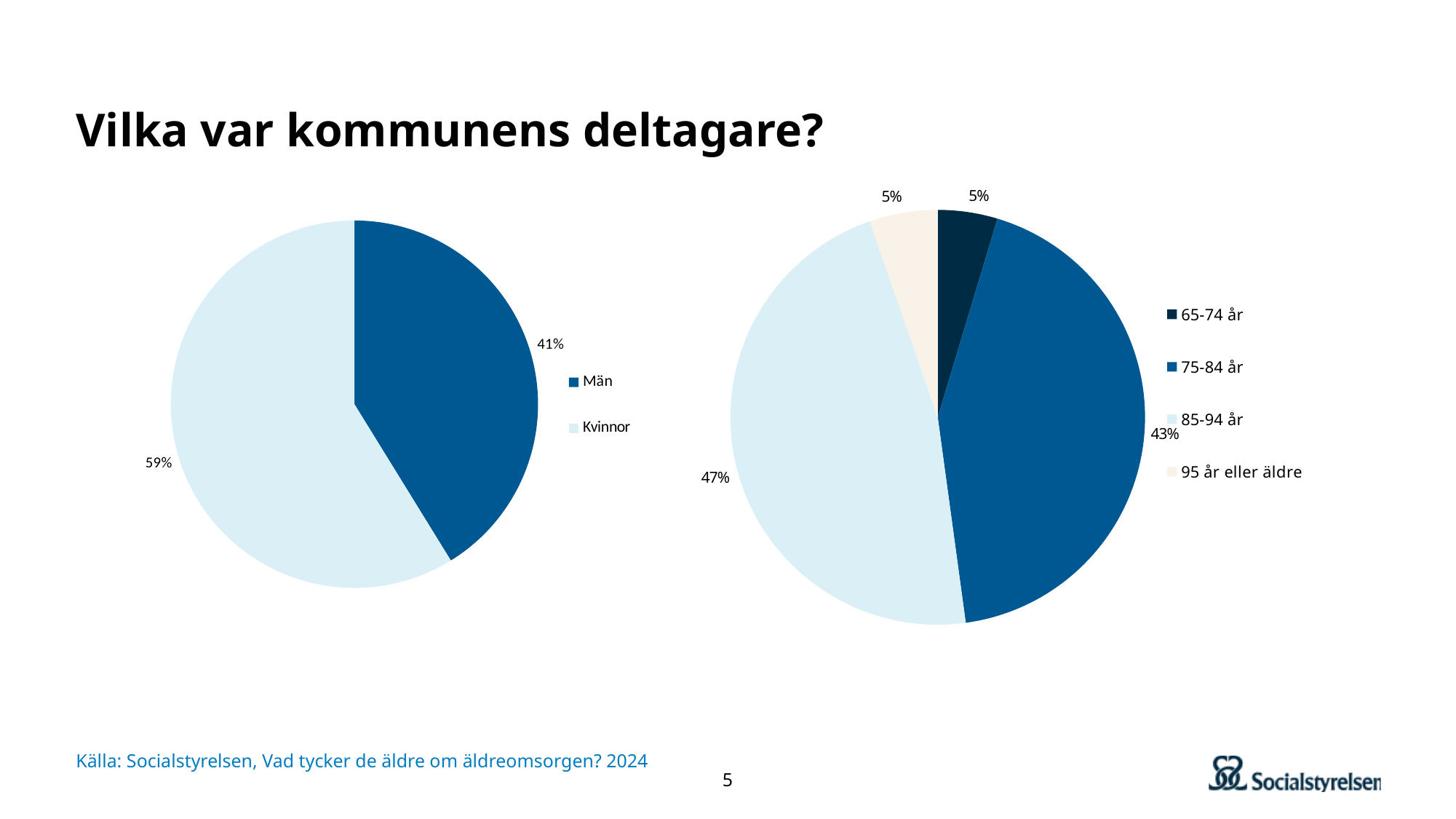
In the right pie chart, which age group has the largest share? 85-94 år In the left pie chart, what is the difference in percentage points between Kvinnor and Män? 18 In the left pie chart, what share is labelled for Män? 41% In the right pie chart, what is the difference in percentage points between 85-94 år and 75-84 år? 4 How many categories does the legend of the left pie chart list? 2 In the left pie chart, which category has the larger share, Män or Kvinnor? Kvinnor In the right pie chart, what share is labelled for 65-74 år? 5% In the right pie chart, what share is labelled for 85-94 år? 47% What kind of chart is the left chart on the slide? Pie chart In the left pie chart, what share is labelled for Kvinnor? 59% In the right pie chart, how many age groups does the legend list? 4 In the right pie chart, what share is labelled for 75-84 år? 43%